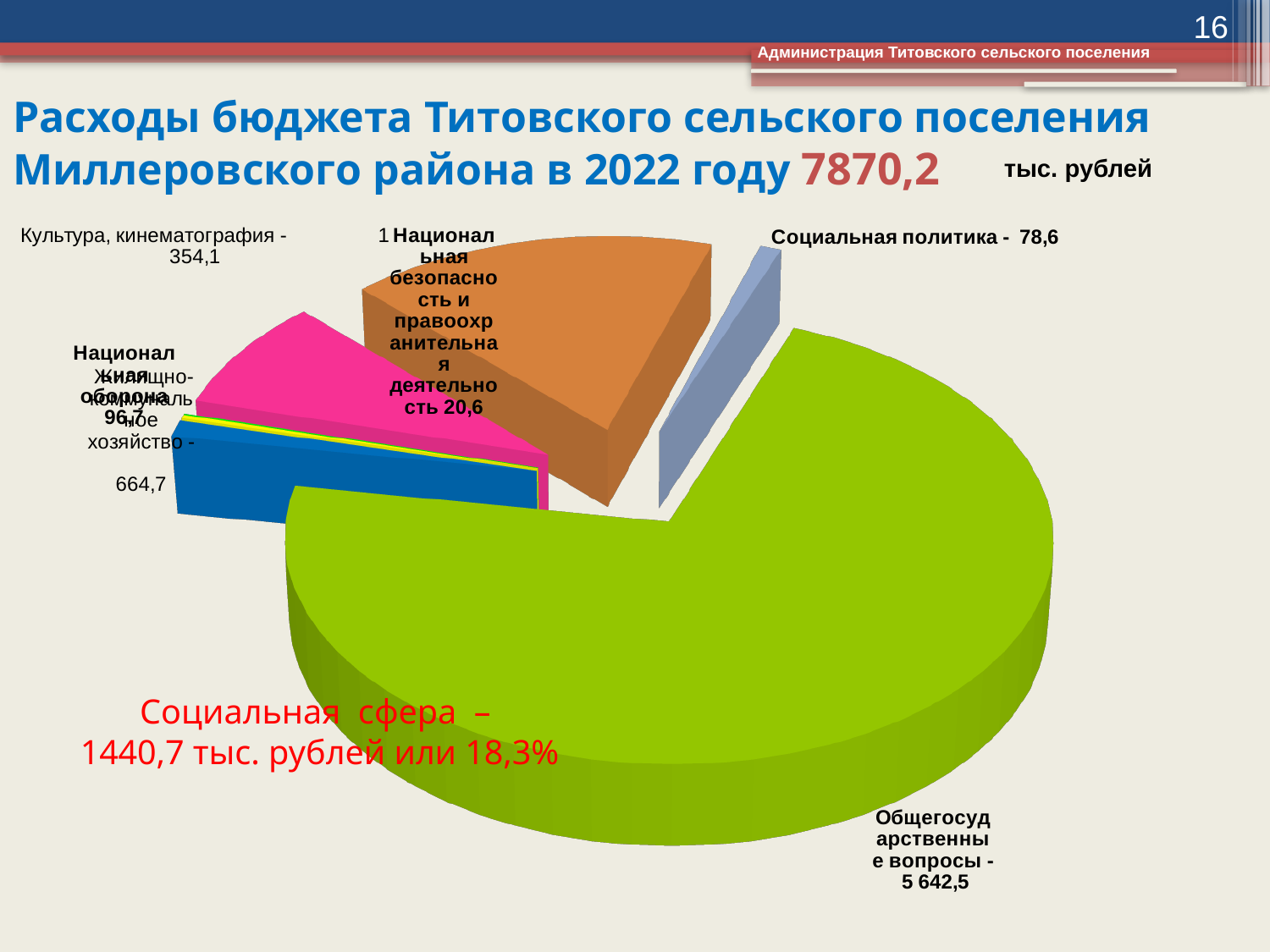
What is the value shown for Жилищно-коммунальное хозяйство? 664,7 What is the difference between Социальная политика and Национальная безопасность и правоохранительная деятельность? 58,0 What is the value shown for Национальная безопасность и правоохранительная деятельность? 20,6 What kind of chart is shown on the slide? Pie chart What total budget expenditure figure is given in the slide title? 7870,2 тыс. рублей What is the difference between Общегосударственные вопросы and Жилищно-коммунальное хозяйство? 4 977,8 Which category has the largest value in the pie chart? Общегосударственные вопросы Which is larger: Культура, кинематография or Социальная политика? Культура, кинематография What is the value shown for Социальная политика? 78,6 What is the value shown for Общегосударственные вопросы? 5 642,5 What is the value shown for Культура, кинематография? 1 354,1